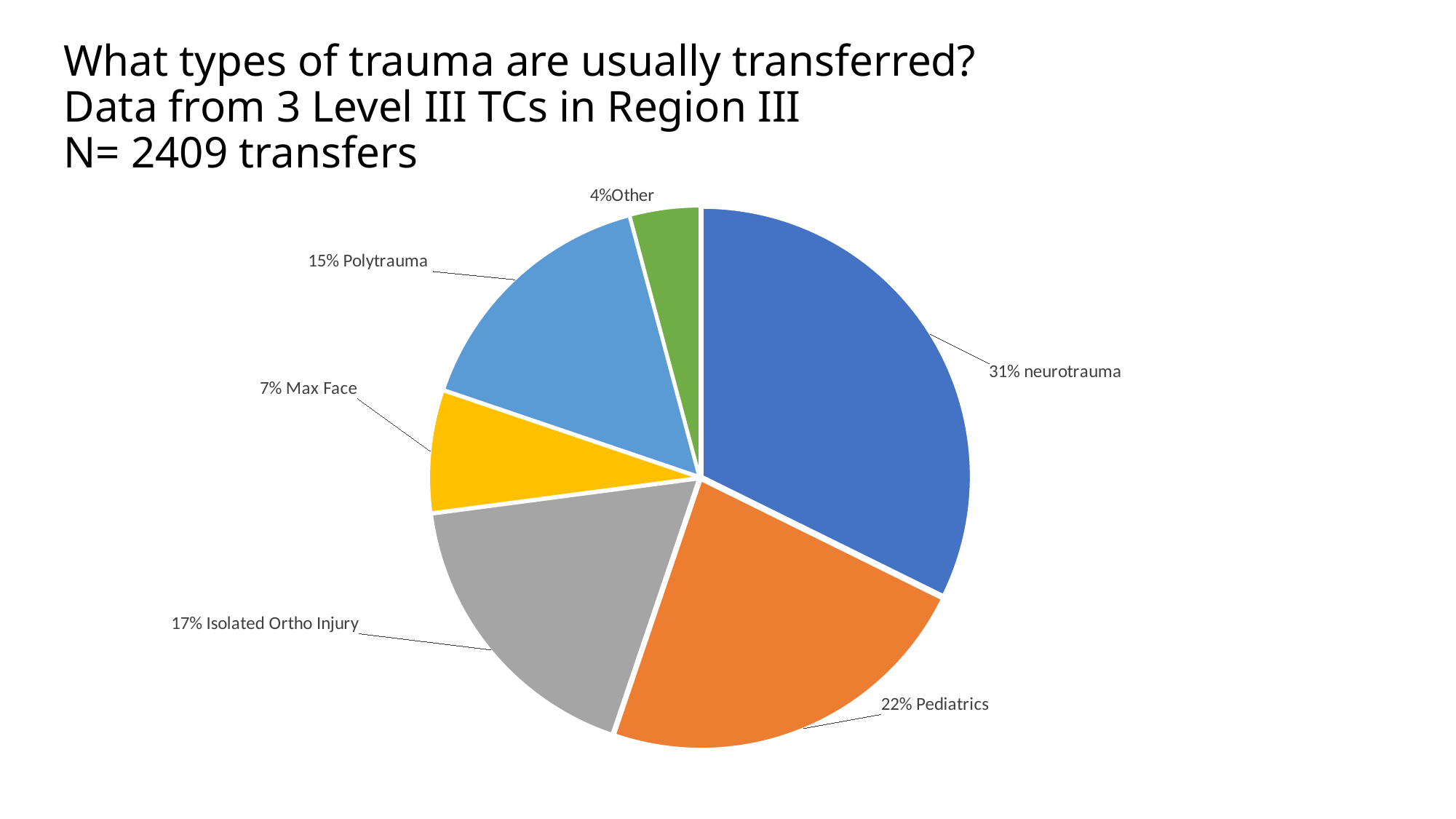
Which category has the smallest slice of the pie? Other What is the difference in percentage points between neurotrauma and Pediatrics? 9 How many categories are shown in the pie chart? 6 What share of transfers is Max Face? 7% What share of transfers is Pediatrics? 22% What share of transfers is Isolated Ortho Injury? 17% Which is larger, the share for Polytrauma or the share for Isolated Ortho Injury? Isolated Ortho Injury What is the total number of transfers stated on the slide? 2409 What share of transfers is neurotrauma? 31% Which category has the largest slice of the pie? neurotrauma What kind of chart is shown on the slide? pie chart What colour is the Polytrauma slice? light blue